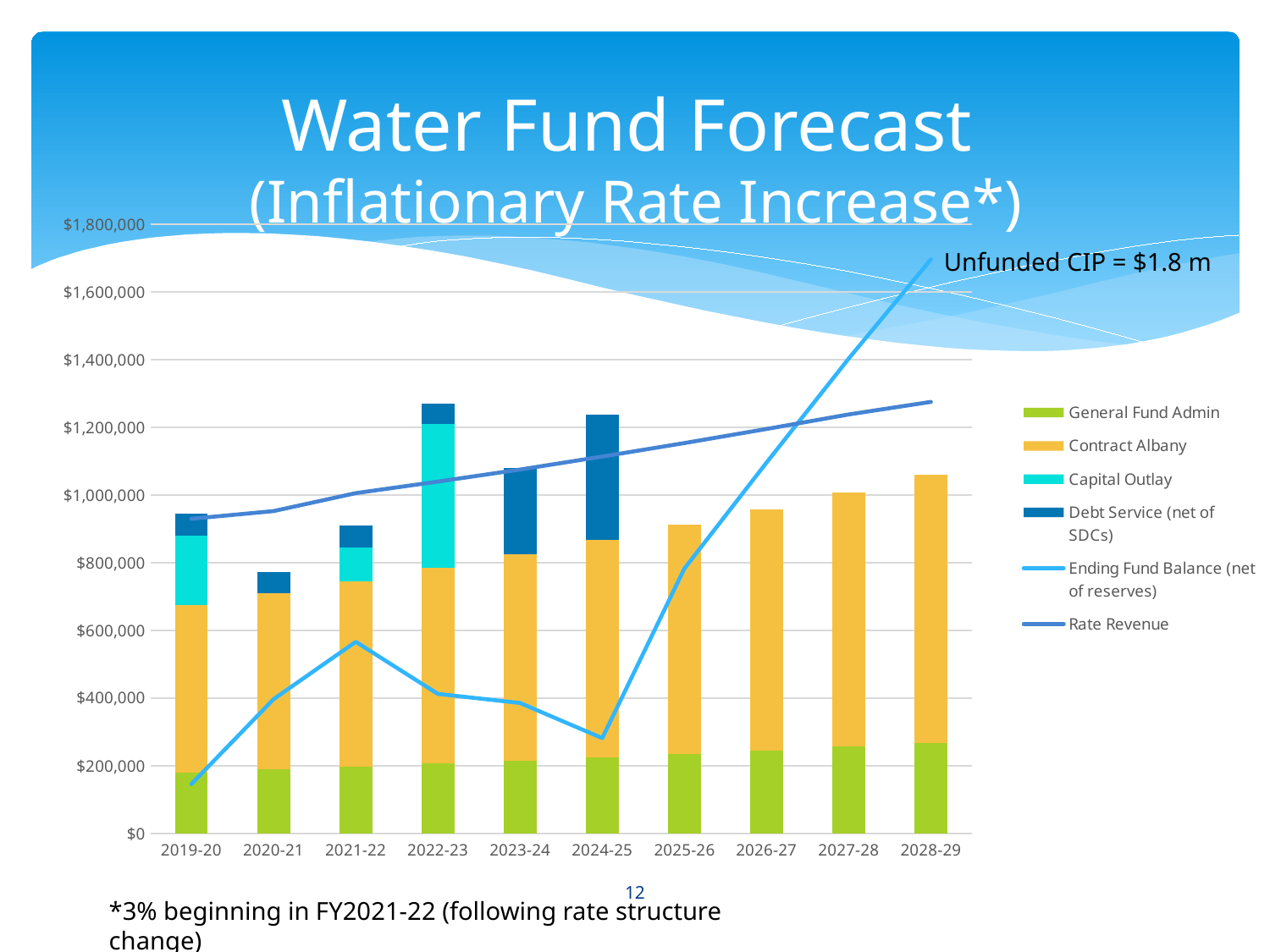
How many fiscal years are shown on the x axis? 10 In which fiscal year is the Ending Fund Balance (net of reserves) line lowest? 2019-20 Which fiscal year has the lowest total stacked bar? 2020-21 Is the Rate Revenue for 2019-20 greater or less than $1,000,000? less How many series does the legend list? 6 Is the Ending Fund Balance (net of reserves) for 2028-29 greater or less than $1,600,000? greater Does the Rate Revenue line rise or fall from 2019-20 to 2028-29? Rises In which fiscal year is the Ending Fund Balance (net of reserves) line highest? 2028-29 Is the total stacked bar for 2022-23 greater or less than $1,200,000? greater What value does the annotation on the chart give for Unfunded CIP? $1.8 m What kind of chart is shown on the slide? A stacked bar chart with line series In 2028-29, which is larger: Rate Revenue or Ending Fund Balance (net of reserves)? Ending Fund Balance (net of reserves)